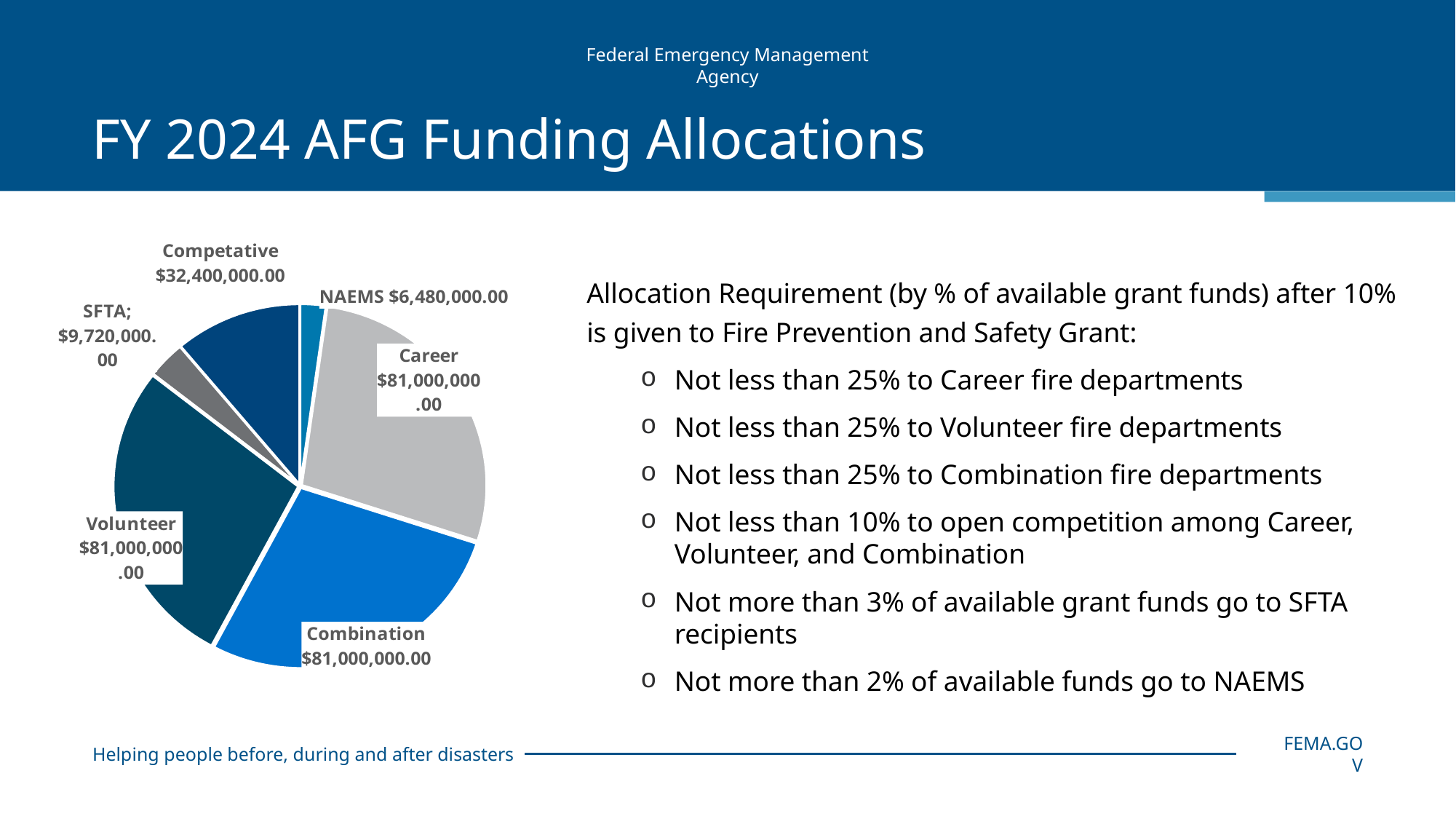
What is the value shown for Competative in the pie chart? $32,400,000.00 How many slices does the pie chart have? 6 What is the difference between the Competative and SFTA values in the pie chart? $22,680,000.00 Which category has the smallest slice in the pie chart? NAEMS What is the value shown for SFTA in the pie chart? $9,720,000.00 What kind of chart is shown on the slide? pie chart What is the value shown for NAEMS in the pie chart? $6,480,000.00 What colour is the Combination slice in the pie chart? bright blue What is the difference between the SFTA and NAEMS values in the pie chart? $3,240,000.00 Which is larger in the pie chart, Competative or SFTA? Competative What is the total of all slices in the pie chart? $291,600,000.00 What is the value shown for Career in the pie chart? $81,000,000.00